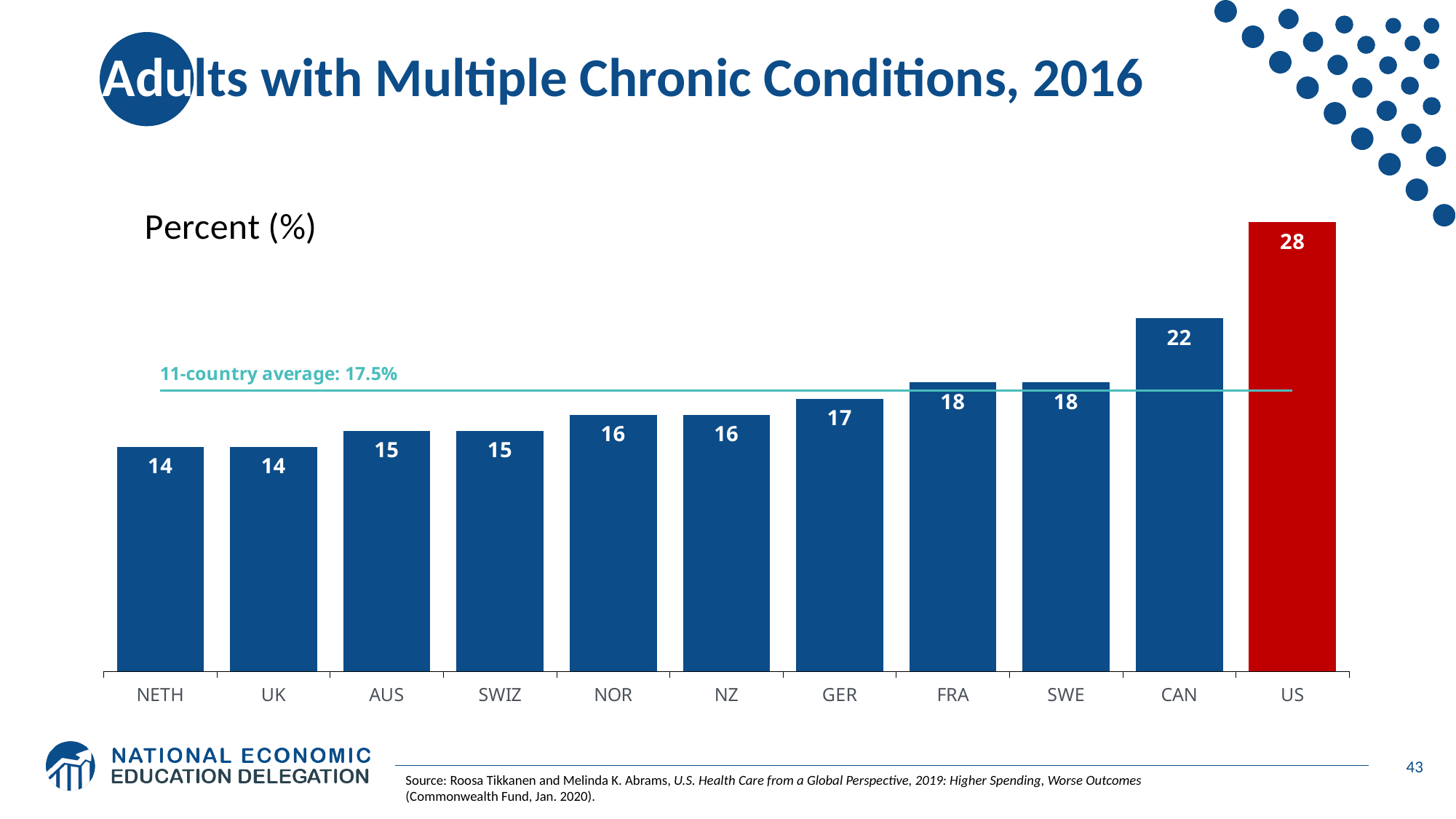
Which has a larger value, NOR or AUS? NOR Which has a larger value, CAN or SWE? CAN What kind of chart is shown on the slide? Bar chart What is the difference between the values for FRA and NETH? 4 What is the value for the US? 28 Do the values rise or fall from left to right across the countries? Rise How many countries are shown on the chart? 11 Which country has the highest value? US What is the value for CAN? 22 What is the difference between the values for the US and CAN? 6 What is the value for GER? 17 What is the 11-country average shown on the chart? 17.5%